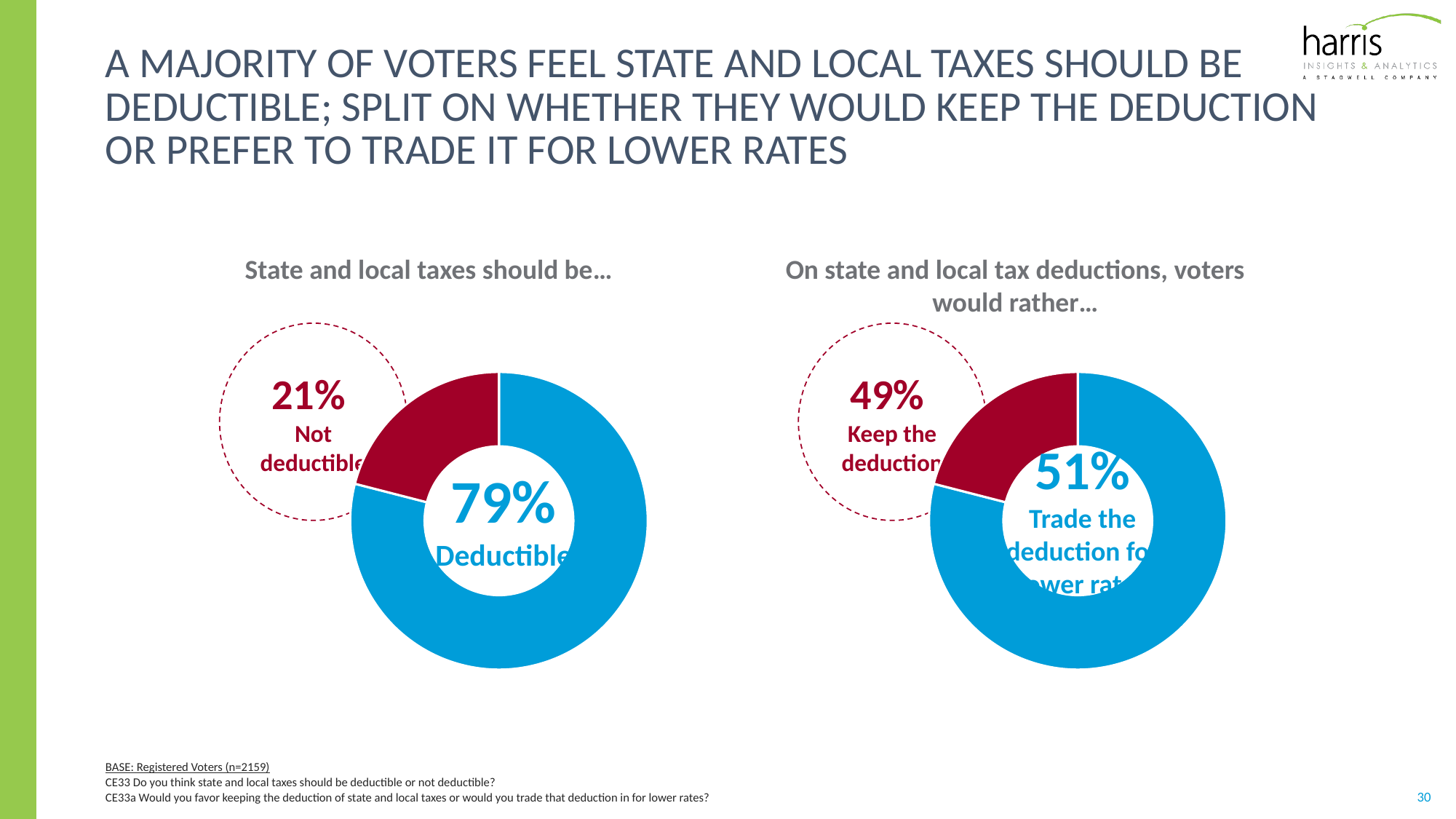
In the chart titled "On state and local tax deductions, voters would rather...", what percentage would keep the deduction? 49% In the chart titled "On state and local tax deductions, voters would rather...", what percentage would trade the deduction for lower rates? 51% How many slices does the right chart have? 2 In the left chart, what is the difference in percentage points between Deductible and Not deductible? 58 What colour is the "Not deductible" slice in the left chart? Red In the left chart, which response has the largest share? Deductible In the chart titled "State and local taxes should be...", what percentage of voters say taxes should be deductible? 79% In the left chart, which response has the smallest share? Not deductible In the right chart, which is larger: the share that would keep the deduction or the share that would trade it for lower rates? Trade the deduction for lower rates In the right chart, what is the difference in percentage points between trading the deduction for lower rates and keeping the deduction? 2 In the chart titled "State and local taxes should be...", what percentage of voters say taxes should be not deductible? 21% What kind of chart is used on the left side of the slide? Donut (pie) chart